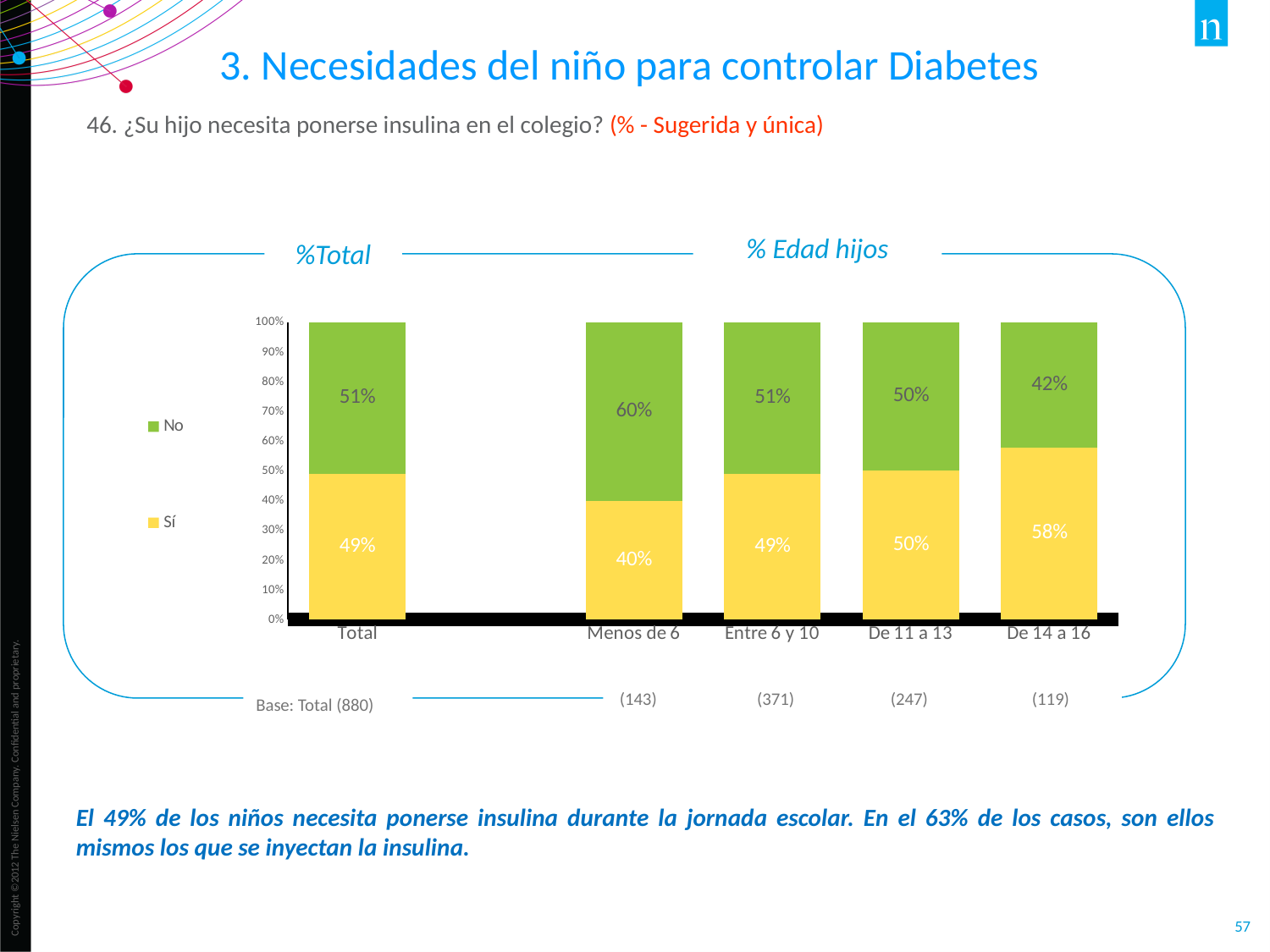
What is the difference between the 'No' value for 'Menos de 6' and the 'No' value for 'De 14 a 16'? 18% What percentage of the 'Sí' series is shown for the 'Total' bar? 49% Which category has the lowest 'Sí' value? Menos de 6 What is the 'No' value for the 'De 11 a 13' category? 50% How many series does the chart legend list? 2 Which category has the highest 'Sí' value? De 14 a 16 What is the 'No' value for the 'Menos de 6' category? 60% What kind of chart is shown on the slide? Stacked bar chart How many categories are shown on the x axis of the chart? 5 Which is larger: the 'Sí' value for 'Entre 6 y 10' or the 'Sí' value for 'De 14 a 16'? De 14 a 16 What is the 'Sí' value for the 'De 14 a 16' category? 58% What is the total of the stacked bar for 'Entre 6 y 10'? 100%